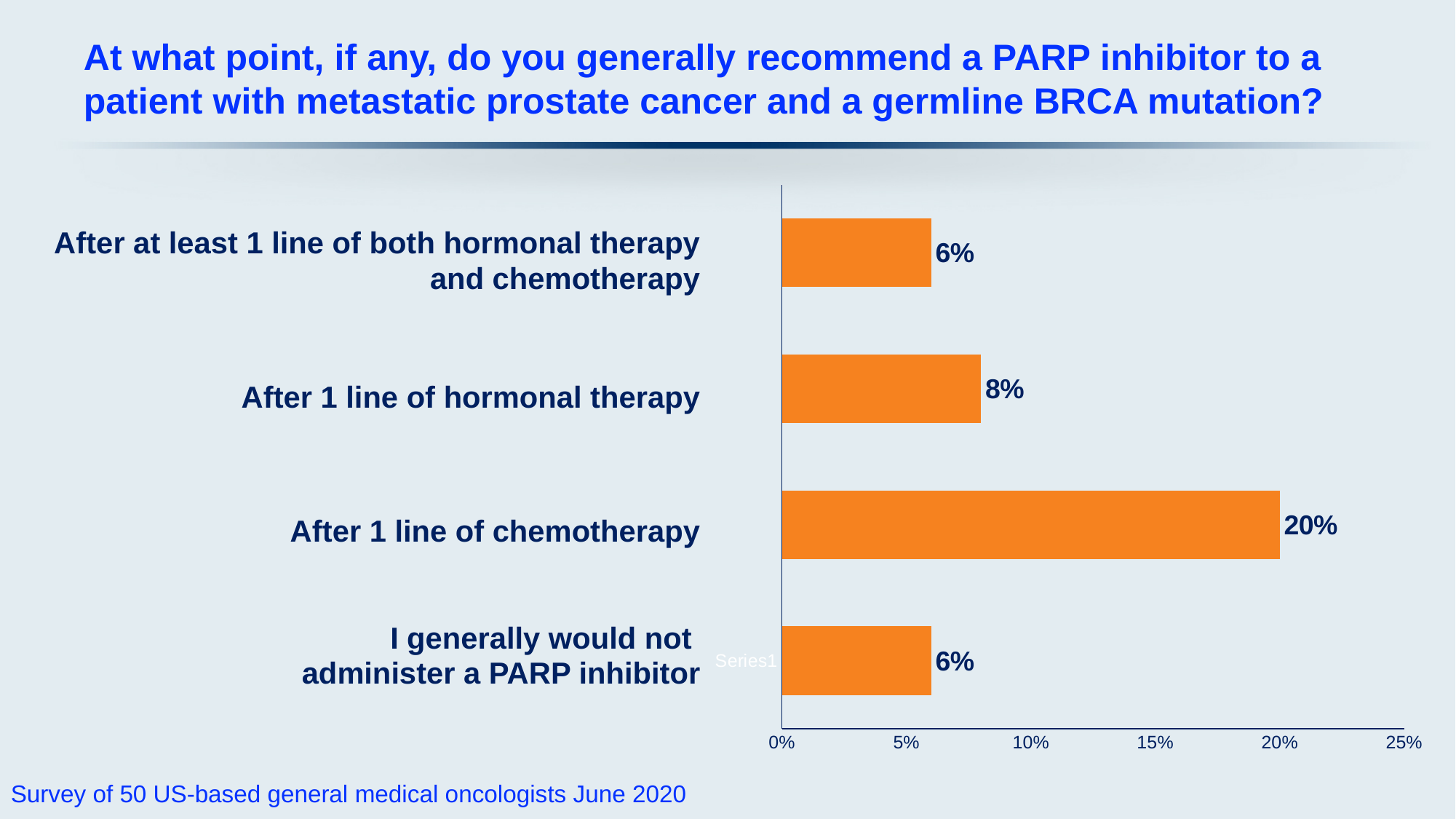
How many response categories are shown in the chart? 4 What is the difference in percentage points between 'After 1 line of hormonal therapy' and 'I generally would not administer a PARP inhibitor'? 2 percentage points What percentage of respondents recommend a PARP inhibitor after at least 1 line of both hormonal therapy and chemotherapy? 6% What type of chart is shown on the slide? Bar chart Is the value for 'After 1 line of chemotherapy' greater or less than 15%? greater What percentage of respondents recommend a PARP inhibitor after 1 line of hormonal therapy? 8% What percentage of respondents recommend a PARP inhibitor after 1 line of chemotherapy? 20% Which is larger: the value for 'After 1 line of hormonal therapy' or the value for 'After at least 1 line of both hormonal therapy and chemotherapy'? After 1 line of hormonal therapy What is the difference in percentage points between 'After 1 line of chemotherapy' and 'After 1 line of hormonal therapy'? 12 percentage points What is the maximum value shown on the horizontal axis? 25% Which response option has the highest percentage? After 1 line of chemotherapy What percentage of respondents said they generally would not administer a PARP inhibitor? 6%